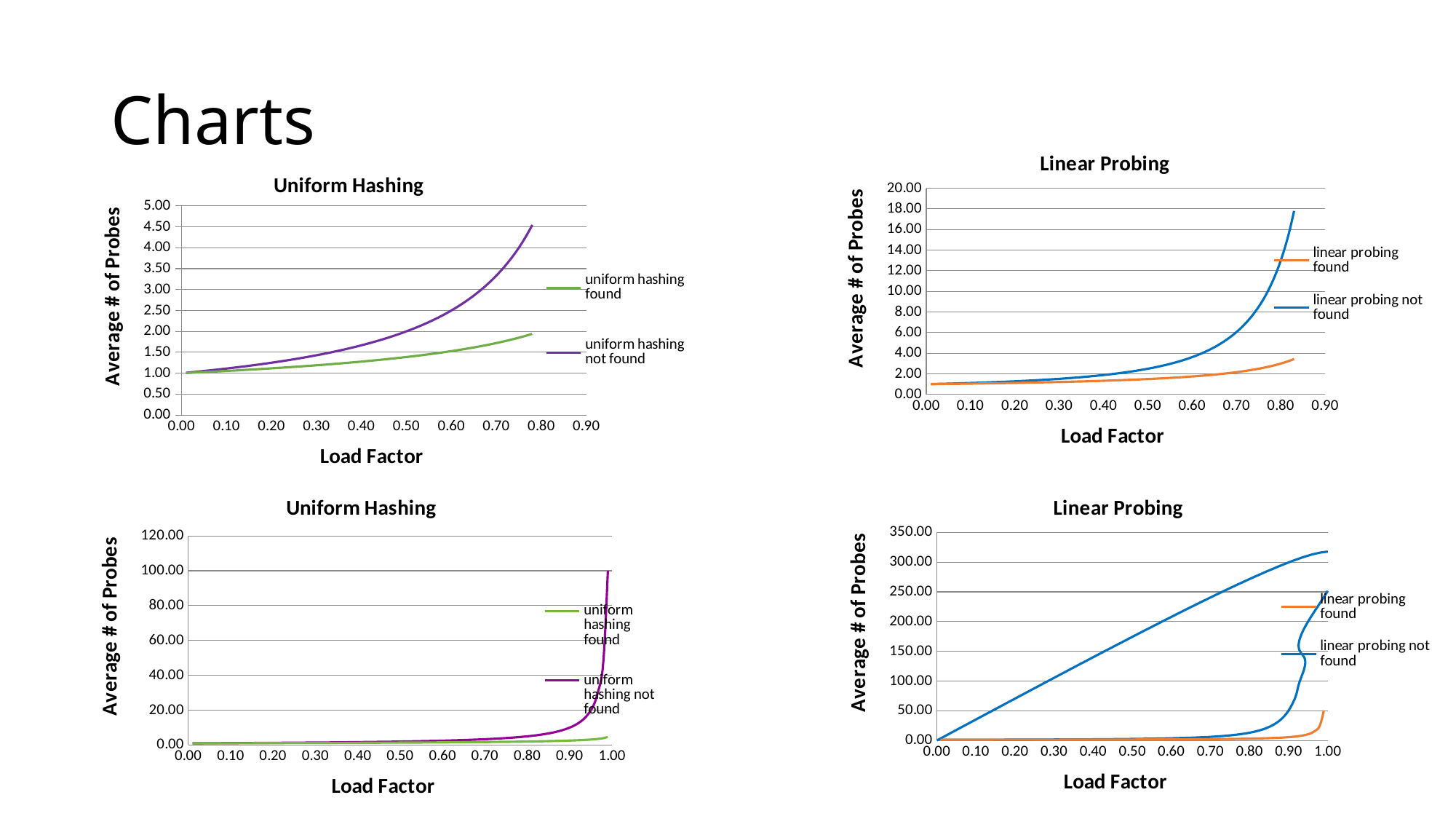
In the top-left Uniform Hashing chart, which series is higher at a load factor of 0.70? uniform hashing not found In the top-left Uniform Hashing chart, does the 'uniform hashing not found' line rise or fall as the load factor increases? rises In the bottom-left Uniform Hashing chart, which series is higher at a load factor of 0.90? uniform hashing not found In the top-right Linear Probing chart, is the value of 'linear probing not found' at a load factor of 0.80 greater or less than 10.00? greater How many series does the legend of the top-right Linear Probing chart list? 2 What kind of chart is the top-left Uniform Hashing chart? line chart How many charts are shown on the slide? 4 In the top-right Linear Probing chart, is the value of 'linear probing found' at a load factor of 0.80 greater or less than 4.00? less What is the y-axis label on the bottom-right Linear Probing chart? Average # of Probes What are the two legend entries on the top-left Uniform Hashing chart? uniform hashing found; uniform hashing not found In the top-left Uniform Hashing chart, is the value of 'uniform hashing not found' at a load factor of 0.60 greater or less than 3.00? less